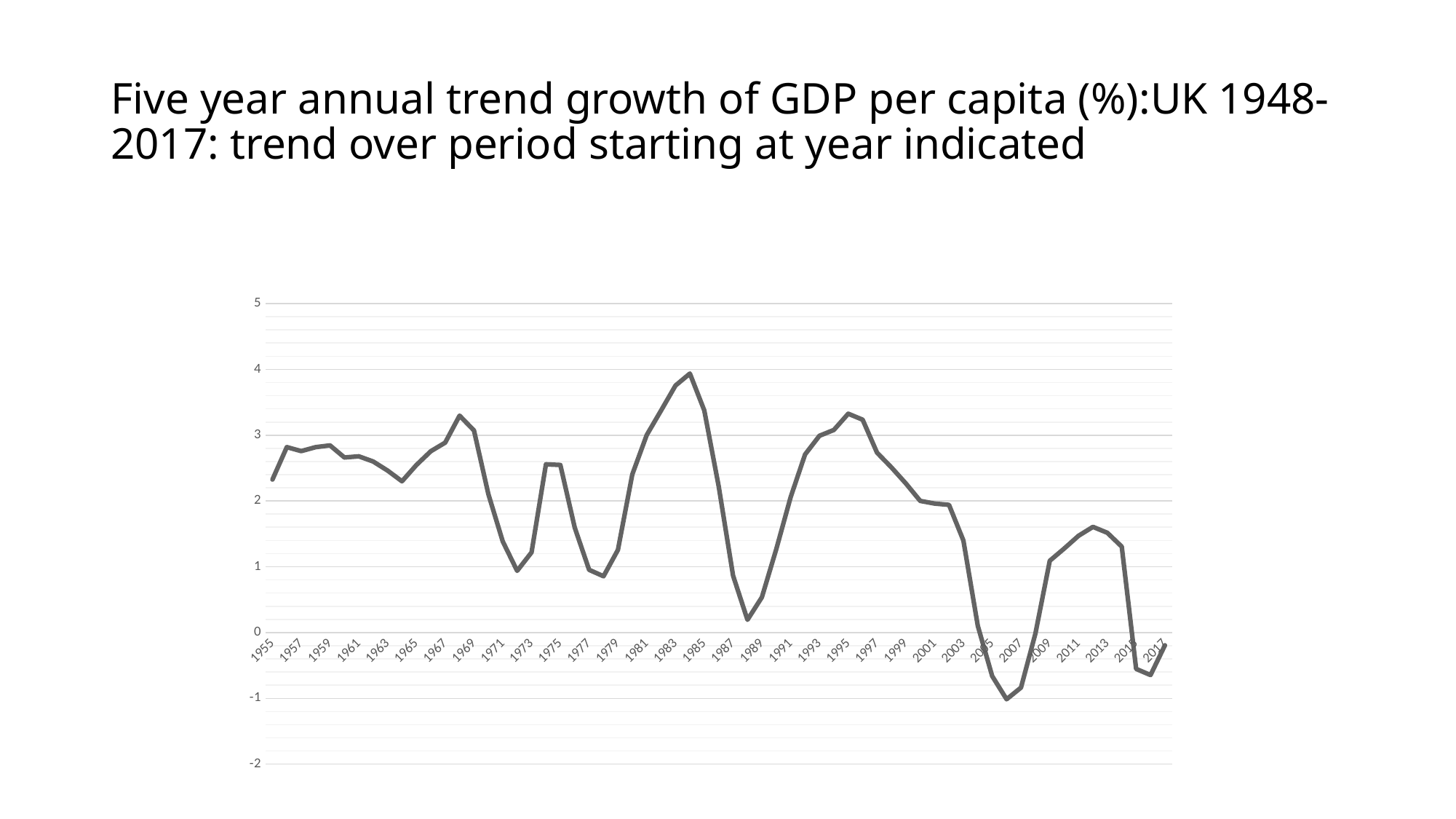
Is the value for 1989 greater or less than 1? less What is the title of the chart on the slide? Five year annual trend growth of GDP per capita (%):UK 1948-2017: trend over period starting at year indicated Is the value for 2005 greater or less than 0? less Is the lowest value on the chart greater or less than 0? less Which is larger, the value for 1983 or the value for 1973? 1983 What kind of chart is shown on the slide? line chart Do the values rise or fall between 1989 and 1995? rise Do the values rise or fall between 1985 and 1989? fall